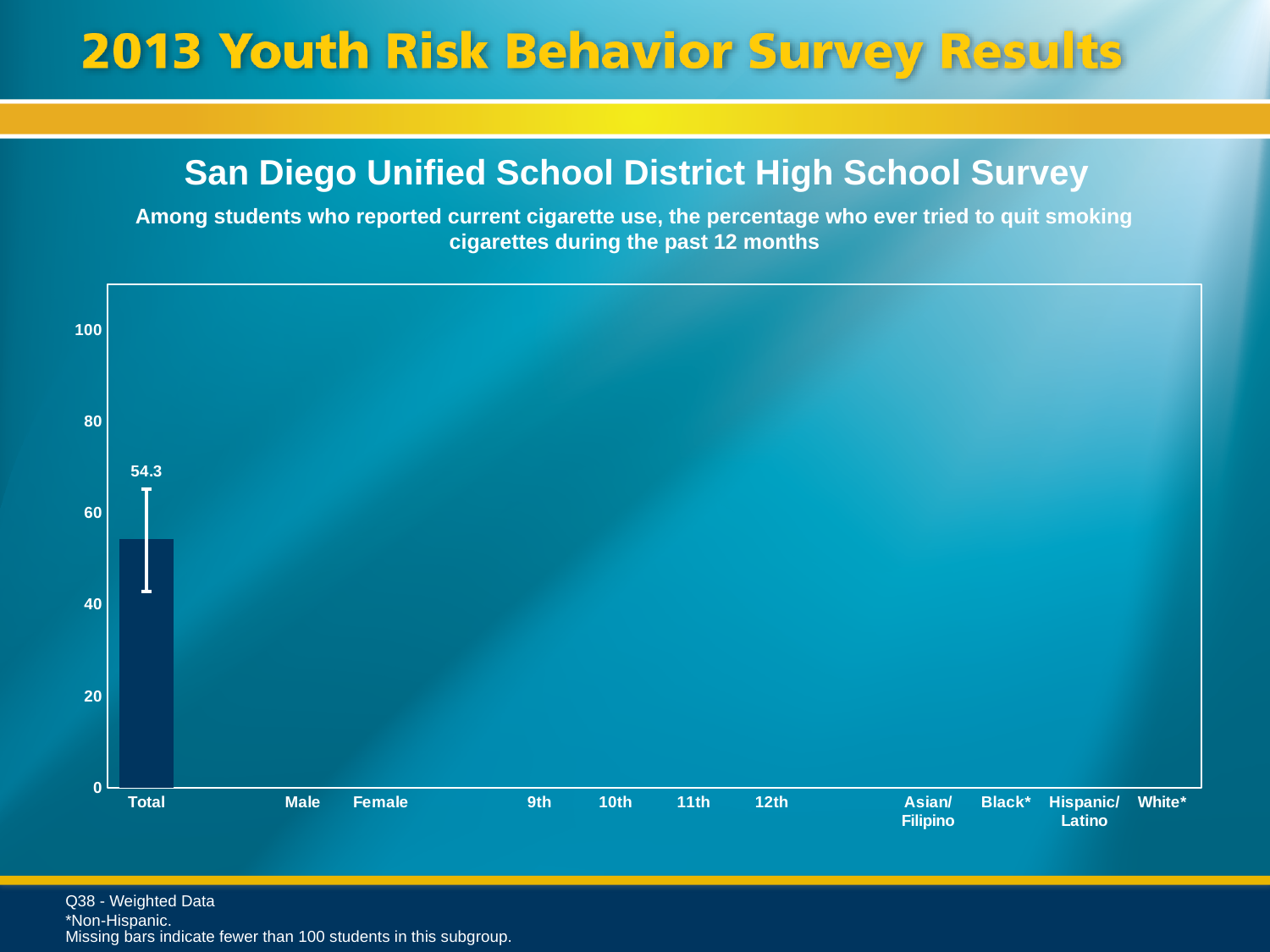
Is the value for Total greater or less than 60? less Which category is the only one with a plotted bar? Total What is the value shown for the Total bar? 54.3 What is the highest tick value shown on the y axis? 100 What kind of chart is shown on the slide? bar chart According to the footnote, what do missing bars indicate? Fewer than 100 students in this subgroup Is the value for Total greater or less than 50? greater How many category labels appear along the x axis? 11 How many bars are actually plotted on the chart? 1